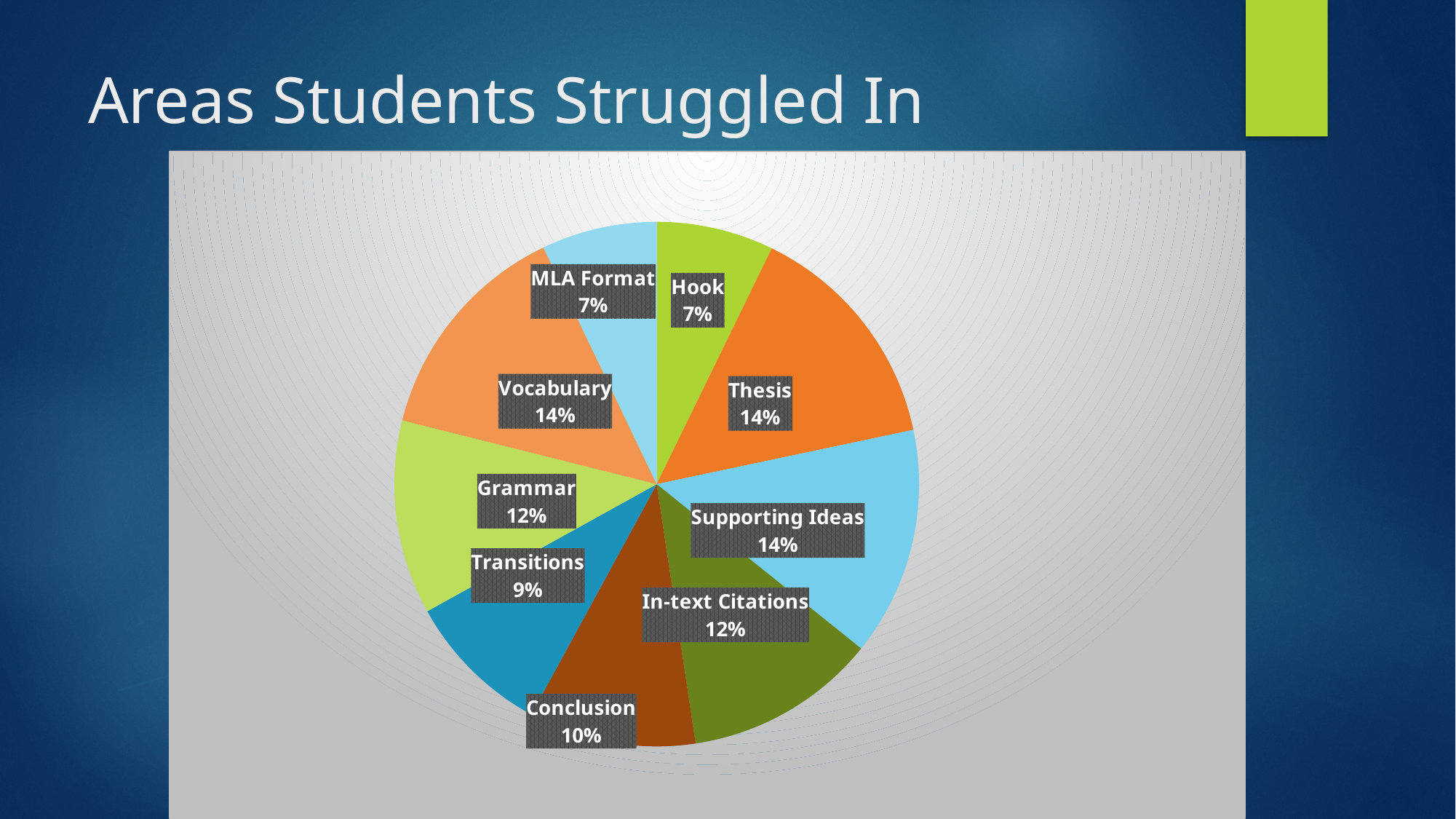
What percentage of the pie does Conclusion represent? 10% What is the value shown for In-text Citations? 12% What kind of chart is shown on the slide? pie chart What is the difference between the Grammar and Conclusion percentages? 2% What is the value shown for Vocabulary? 14% What is the value shown for MLA Format? 7% How many slices does the pie chart have? 9 What is the difference between the Thesis and Hook percentages? 7% Which is larger, Hook or Conclusion? Conclusion Which is larger, Grammar or Transitions? Grammar What is the title of the slide containing the chart? Areas Students Struggled In What is the value shown for Transitions? 9%